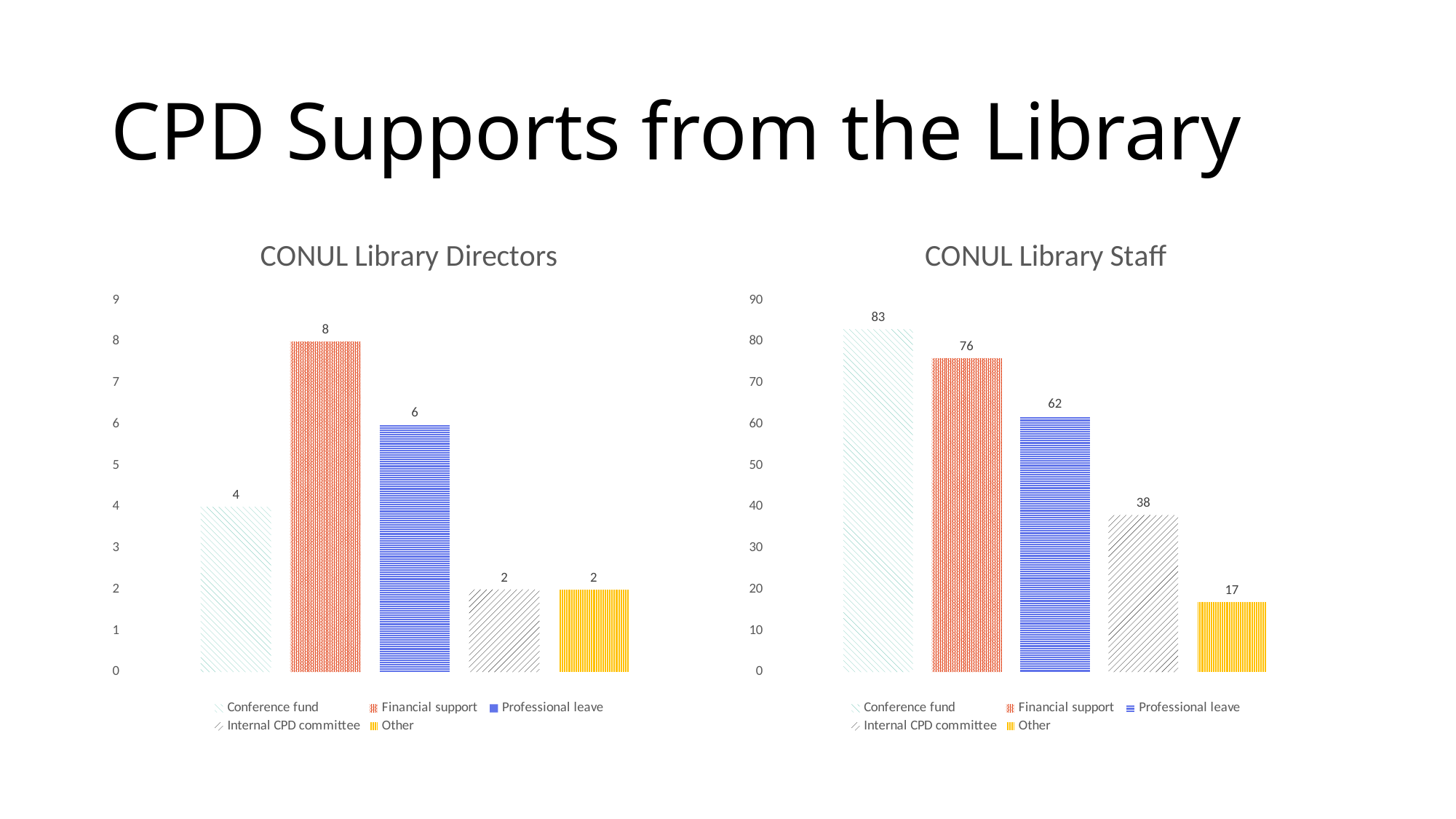
In the CONUL Library Directors chart, what is the difference between Financial support and Professional leave? 2 In the CONUL Library Staff chart, which category has the lowest value? Other In the CONUL Library Staff chart, which is larger, Professional leave or Internal CPD committee? Professional leave In the CONUL Library Staff chart, what is the value for Conference fund? 83 In the CONUL Library Staff chart, is the value for Other greater or less than 20? less In the CONUL Library Directors chart, which category has the highest value? Financial support In the CONUL Library Staff chart, what is the difference between Conference fund and Financial support? 7 What kind of chart is the CONUL Library Staff chart? bar chart In the CONUL Library Directors chart, what is the value for Financial support? 8 In the CONUL Library Directors chart, which two categories share the same value of 2? Internal CPD committee and Other How many categories are shown in the CONUL Library Directors chart? 5 In the CONUL Library Staff chart, what is the value for Internal CPD committee? 38